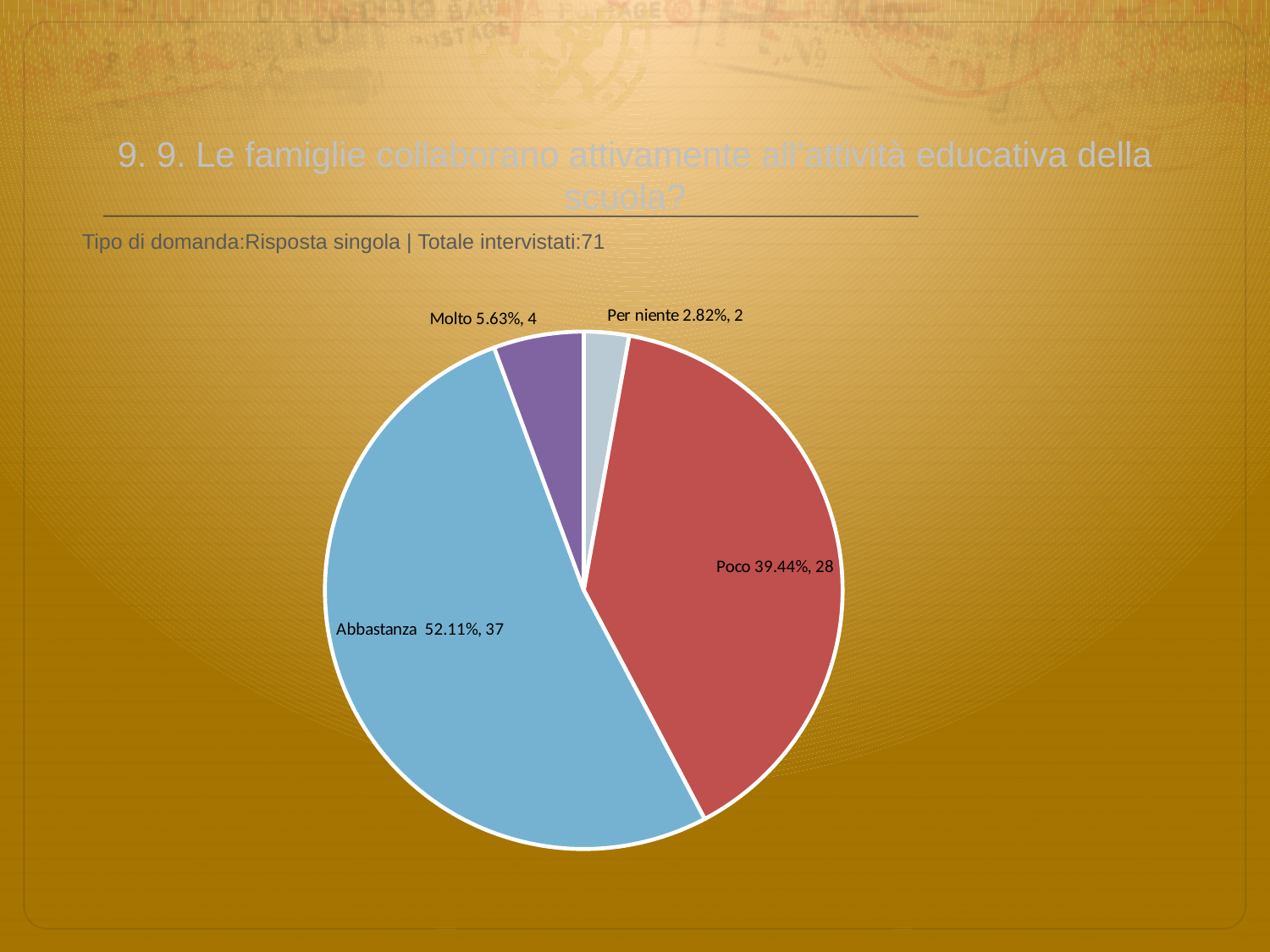
What is the difference in respondent count between Abbastanza and Poco? 9 How many respondents answered Molto? 4 Which category has the largest slice? Abbastanza What kind of chart is shown on the slide? pie chart Which has more respondents, Molto or Per niente? Molto How many respondents answered Poco? 28 What percentage share does the Abbastanza slice have? 52.11% How many slices does the pie chart have? 4 Which category has the smallest slice? Per niente What percentage share does the Poco slice have? 39.44% How many respondents answered Per niente? 2 What is the total number of respondents stated on the slide? 71